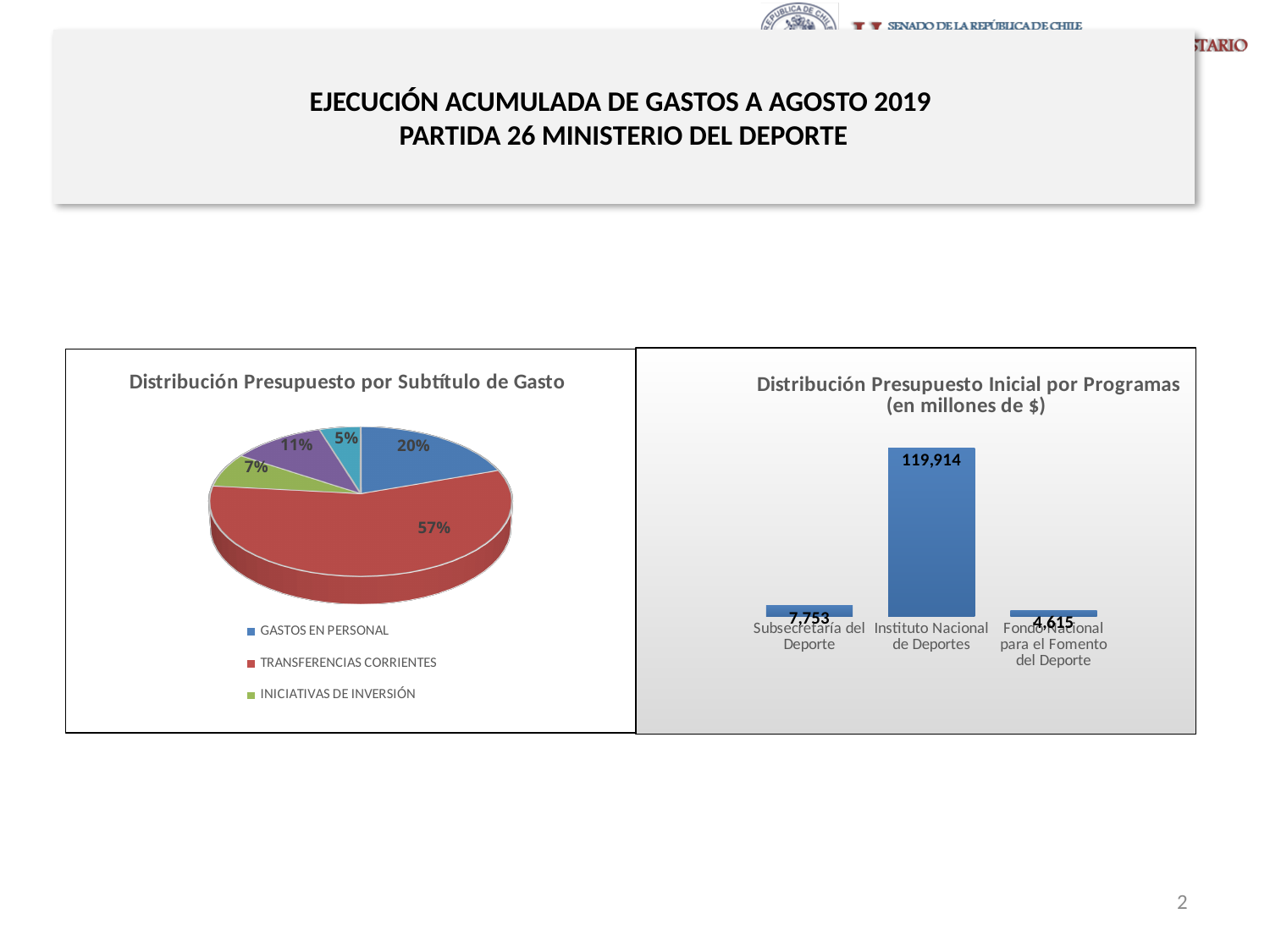
In the pie chart 'Distribución Presupuesto por Subtítulo de Gasto', what share does GASTOS EN PERSONAL have? 20% What kind of chart is 'Distribución Presupuesto Inicial por Programas'? bar chart In the pie chart 'Distribución Presupuesto por Subtítulo de Gasto', which category has the largest slice? TRANSFERENCIAS CORRIENTES In the chart 'Distribución Presupuesto Inicial por Programas', what is the value for Fondo Nacional para el Fomento del Deporte? 4,615 In the pie chart 'Distribución Presupuesto por Subtítulo de Gasto', what share does TRANSFERENCIAS CORRIENTES have? 57% In the chart 'Distribución Presupuesto Inicial por Programas', which program has the highest value? Instituto Nacional de Deportes In the chart 'Distribución Presupuesto Inicial por Programas', what is the value for Instituto Nacional de Deportes? 119,914 How many programs are shown in the chart 'Distribución Presupuesto Inicial por Programas'? 3 In the chart 'Distribución Presupuesto Inicial por Programas', which program has the lowest value? Fondo Nacional para el Fomento del Deporte In the chart 'Distribución Presupuesto Inicial por Programas', what is the difference between the values for Instituto Nacional de Deportes and Subsecretaría del Deporte? 112,161 In the chart 'Distribución Presupuesto Inicial por Programas', which is larger: Subsecretaría del Deporte or Fondo Nacional para el Fomento del Deporte? Subsecretaría del Deporte In the chart 'Distribución Presupuesto Inicial por Programas', what is the value for Subsecretaría del Deporte? 7,753